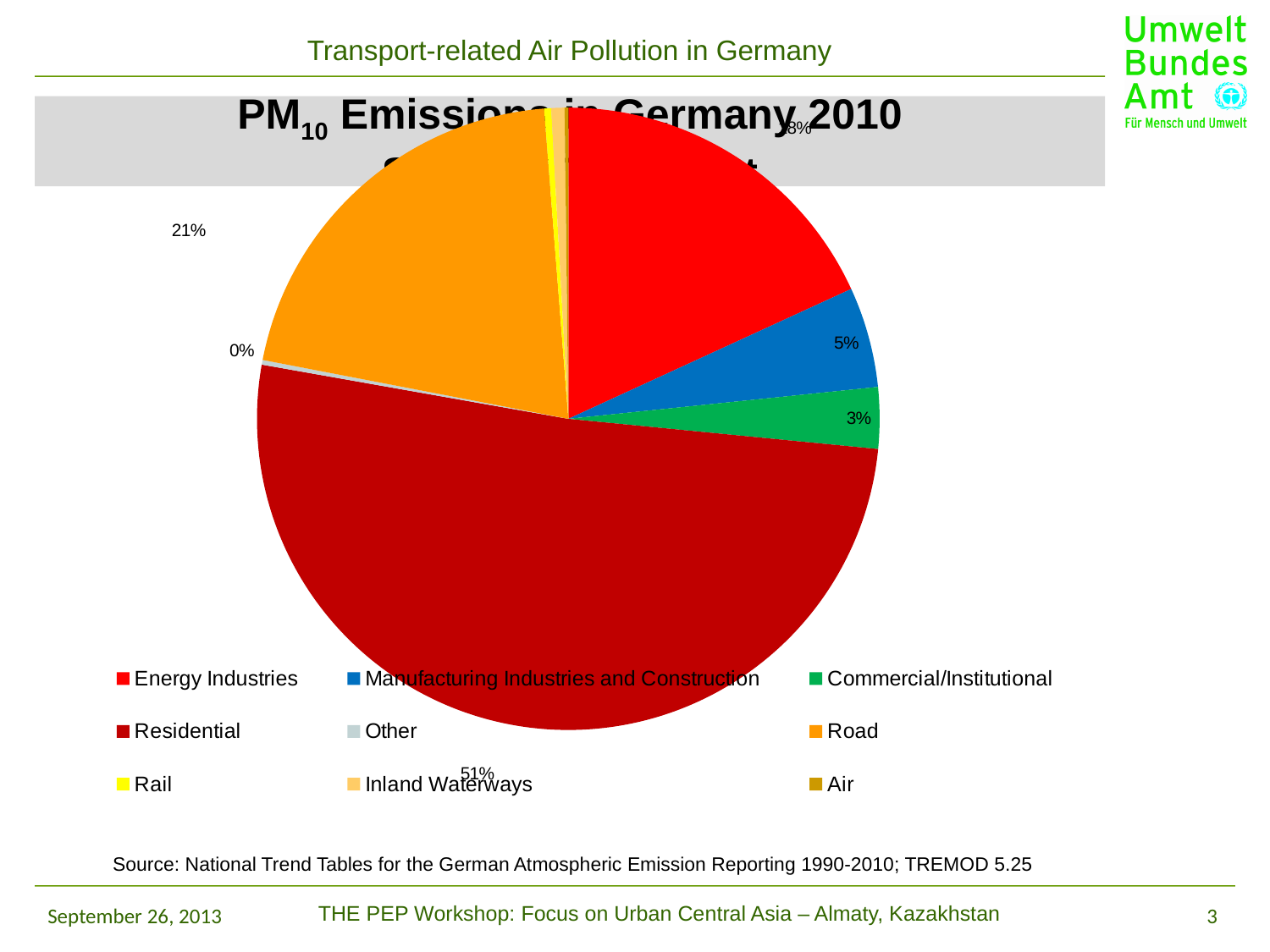
Which category has the largest slice of the pie? Residential By how many percentage points does the Road share exceed the Manufacturing Industries and Construction share? 16% What kind of chart is shown on the slide? pie chart By how many percentage points does the Residential share exceed the Road share? 30% What share is shown for Commercial/Institutional? 3% How many categories does the legend of the pie chart list? 9 What share of PM10 emissions does the Residential slice account for? 51% What share of PM10 emissions does the Road slice account for? 21% What percentage is labelled for the Other category? 0% Which is larger, the Road share or the Manufacturing Industries and Construction share? Road What share is shown for Manufacturing Industries and Construction? 5% What colour is used for the Road slice in the pie chart? orange